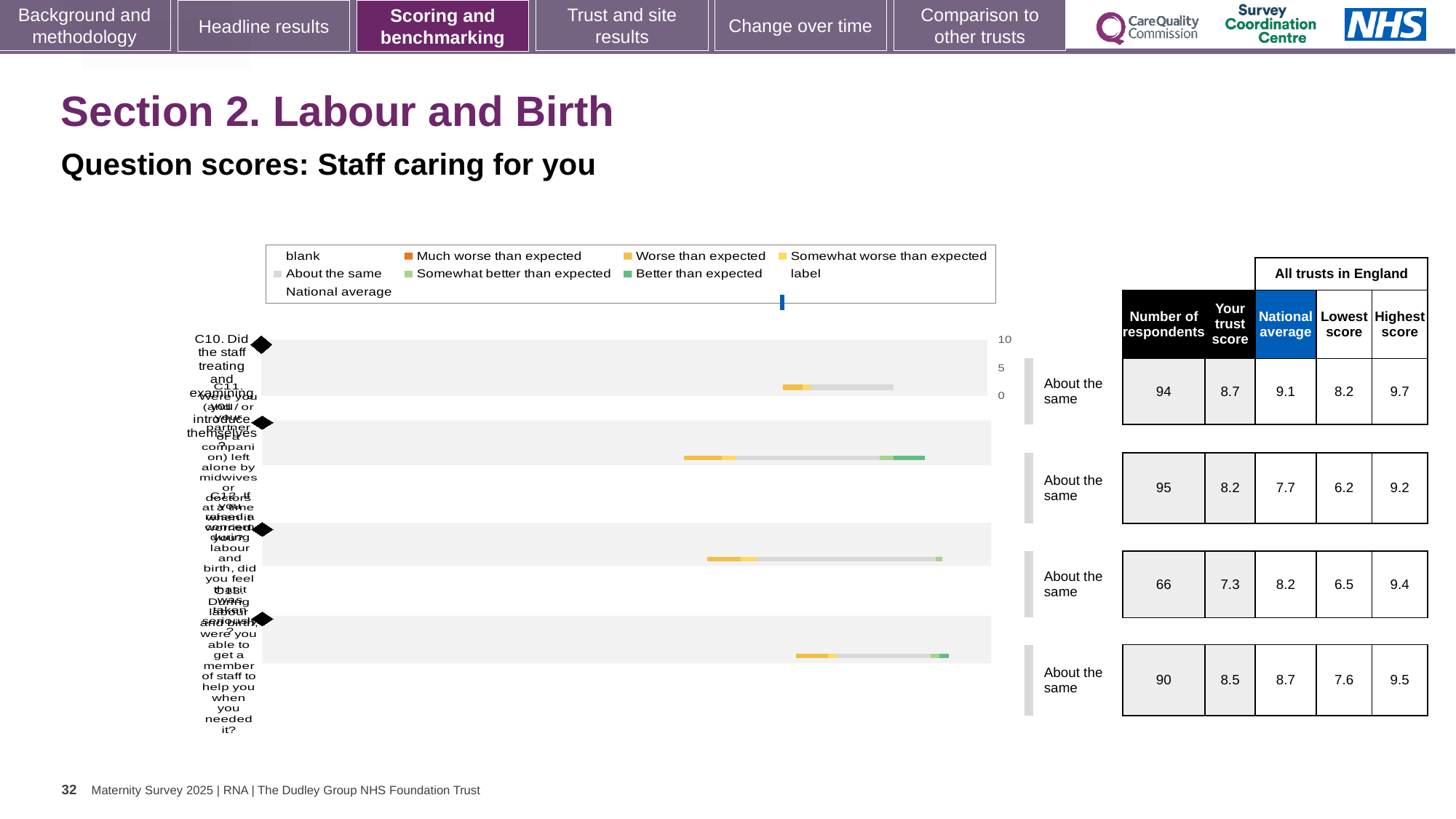
What is the lowest score among all trusts in England for the fourth row (C13)? 7.6 How many question rows are plotted in the chart? 4 What is the 'Your trust score' for the first row (C10) in the table beside the chart? 8.7 What is the national average for the first row (C10)? 9.1 Which row has the highest number of respondents? second row (C11), 95 What is the number of respondents for the second row (C11)? 95 For the third row (C12), which is larger: 'Your trust score' or the national average? national average What kind of chart is shown on the slide? bar chart What is the highest score among all trusts in England for the third row (C12)? 9.4 What is the difference between the national average and 'Your trust score' for the first row (C10)? 0.4 What comparison label is shown for every row in the chart? About the same Which row has the lowest 'Your trust score'? third row (C12), 7.3